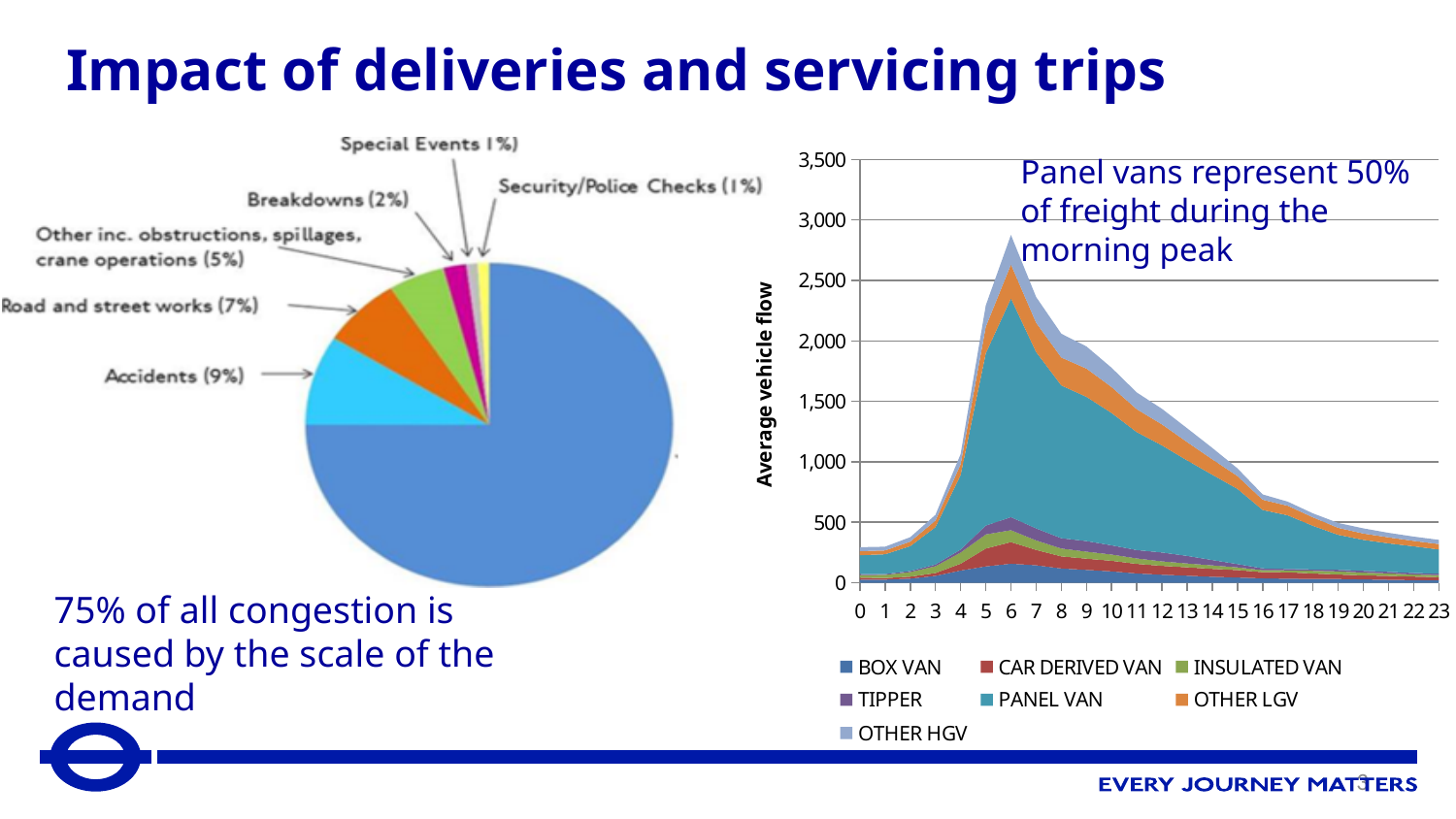
In the pie chart on the left, how many percentage points larger is the Accidents share than the Road and street works share? 2 percentage points In the pie chart on the left, which is larger: the Breakdowns slice or the 'Other inc. obstructions, spillages, crane operations' slice? Other inc. obstructions, spillages, crane operations (5%) What kind of chart is the chart on the right showing average vehicle flow? Stacked area chart In the pie chart on the left, what share is attributed to Breakdowns? 2% In the pie chart on the left, what share is attributed to Road and street works? 7% In the pie chart on the left, which of the labelled slices has the largest share? Accidents (9%) In the chart on the right, at which hour is the total average vehicle flow highest? 6 In the chart on the right, is the total average vehicle flow at hour 0 greater or less than 500? less How many series does the legend of the chart on the right list? 7 In the pie chart on the left, what share of congestion is attributed to Accidents? 9% In the pie chart on the left, what share is attributed to Special Events? 1% In the chart on the right, is the total average vehicle flow at hour 6 greater or less than 2,500? greater